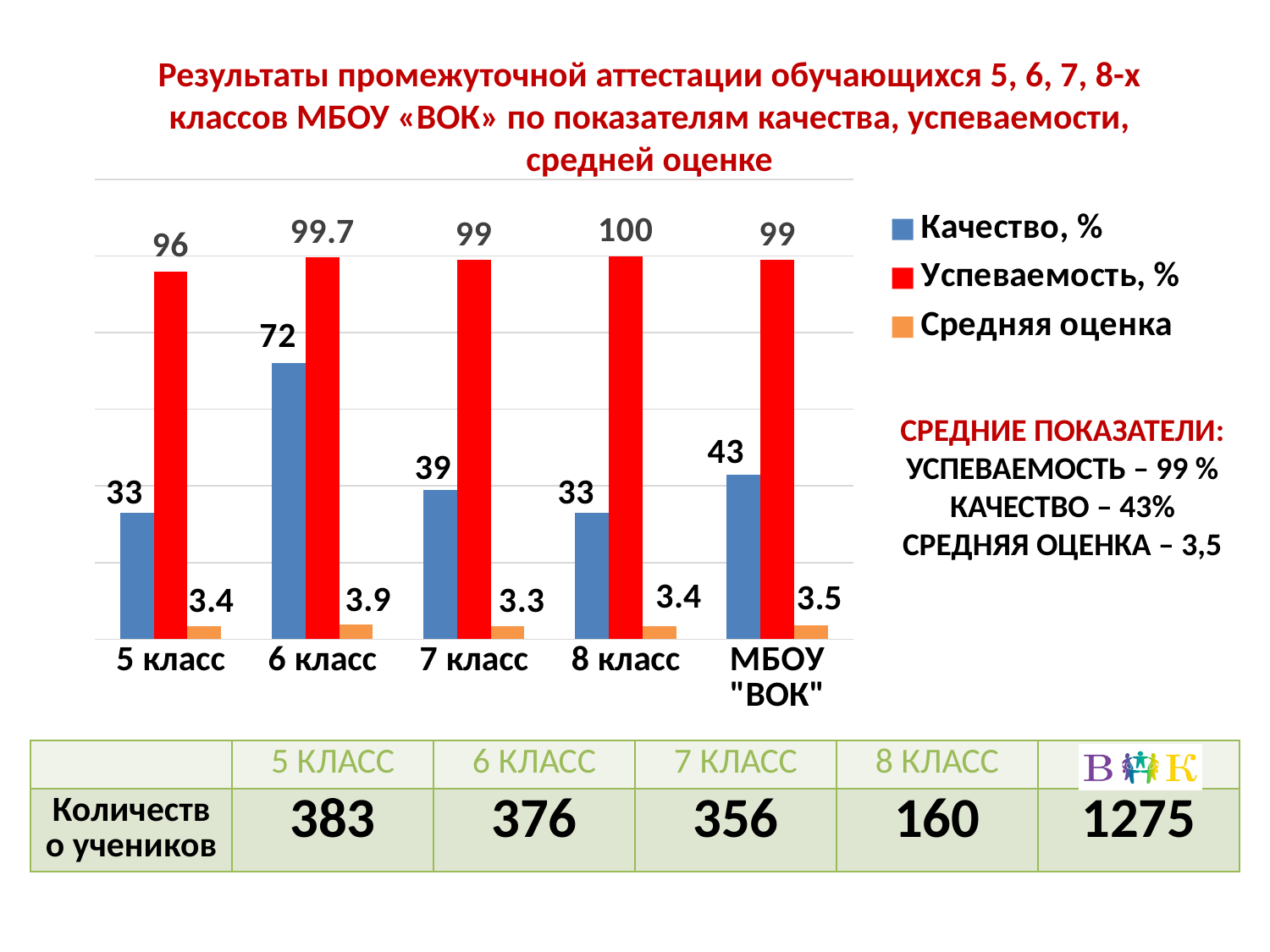
What is the Средняя оценка for 7 класс? 3.3 What is the value of Качество, % for 6 класс? 72 What is the value of Успеваемость, % for 8 класс? 100 What is the value of Успеваемость, % for 6 класс? 99.7 Which category has the highest value for Качество, %? 6 класс What colour are the bars for the Успеваемость, % series? red How many categories are shown on the x axis of the chart? 5 What is the difference between the Качество, % values for 6 класс and 5 класс? 39 Which is larger: the Качество, % value for 7 класс or for МБОУ "ВОК"? МБОУ "ВОК" Which category has the lowest value for Средняя оценка? 7 класс What kind of chart is shown on the slide? bar chart How many series does the chart legend list? 3